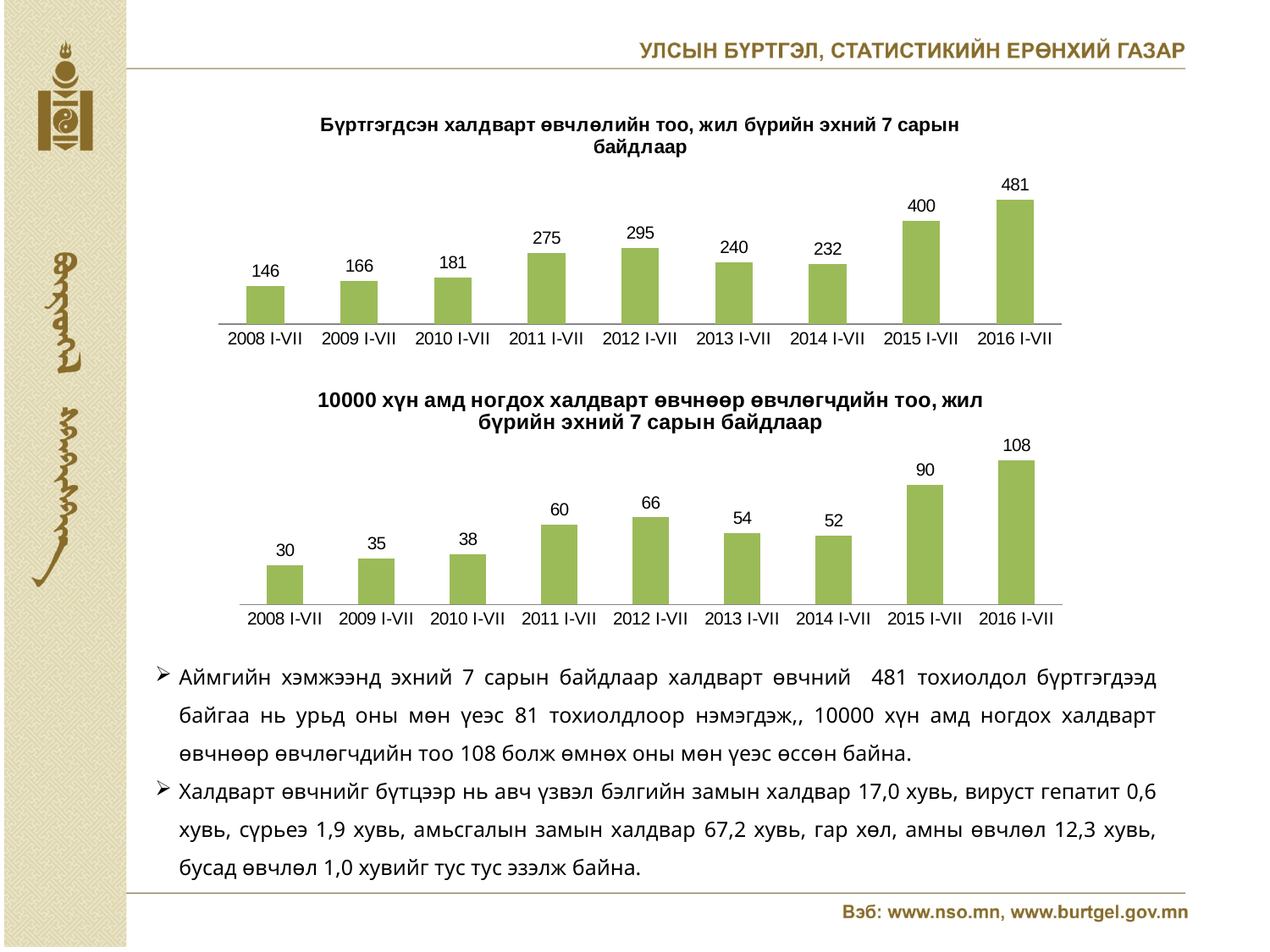
What type of chart is the top chart (Бүртгэгдсэн халдварт өвчлөлийн тоо)? Bar chart In the top chart (Бүртгэгдсэн халдварт өвчлөлийн тоо), what is the difference between the values for 2016 I-VII and 2015 I-VII? 81 In the bottom chart (10000 хүн амд ногдох халдварт өвчнөөр өвчлөгчдийн тоо), do the values rise or fall from 2014 I-VII to 2016 I-VII? Rise In the bottom chart (10000 хүн амд ногдох халдварт өвчнөөр өвчлөгчдийн тоо), which year has the highest value? 2016 I-VII In the bottom chart (10000 хүн амд ногдох халдварт өвчнөөр өвчлөгчдийн тоо), what is the difference between the values for 2016 I-VII and 2008 I-VII? 78 In the top chart (Бүртгэгдсэн халдварт өвчлөлийн тоо), how many bars are plotted? 9 In the bottom chart (10000 хүн амд ногдох халдварт өвчнөөр өвчлөгчдийн тоо), what is the value for 2011 I-VII? 60 In the top chart (Бүртгэгдсэн халдварт өвчлөлийн тоо), which year has the lowest value? 2008 I-VII In the top chart (Бүртгэгдсэн халдварт өвчлөлийн тоо), what is the value for 2016 I-VII? 481 In the top chart (Бүртгэгдсэн халдварт өвчлөлийн тоо), what is the value for 2010 I-VII? 181 In the bottom chart (10000 хүн амд ногдох халдварт өвчнөөр өвчлөгчдийн тоо), which is larger, the value for 2013 I-VII or 2014 I-VII? 2013 I-VII In the top chart (Бүртгэгдсэн халдварт өвчлөлийн тоо), which is larger, the value for 2012 I-VII or 2013 I-VII? 2012 I-VII